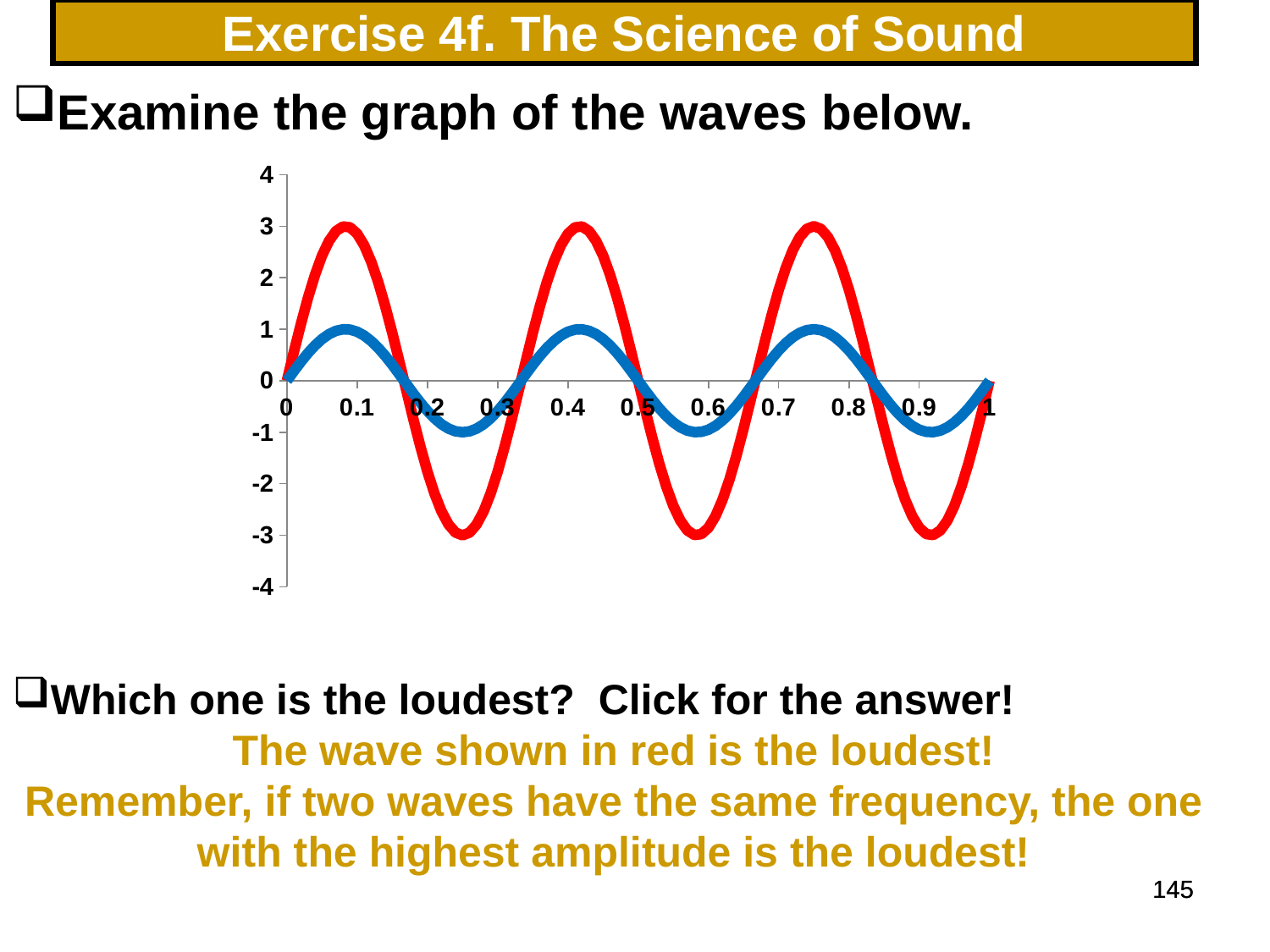
What is the maximum value reached by the red wave? 3 Is the peak value of the red wave greater or less than 2? greater What is the minimum value reached by the red wave? -3 What is the maximum value reached by the blue wave? 1 How many peaks does the red wave have between x = 0 and x = 1? 3 Is the peak value of the blue wave greater or less than 2? less What kind of chart is shown on the slide? line chart Which wave reaches the higher peak value, the red or the blue? red Which wave has the smaller amplitude? blue What is the minimum value reached by the blue wave? -1 How many waves are plotted on the chart? 2 What is the highest value shown on the vertical axis? 4